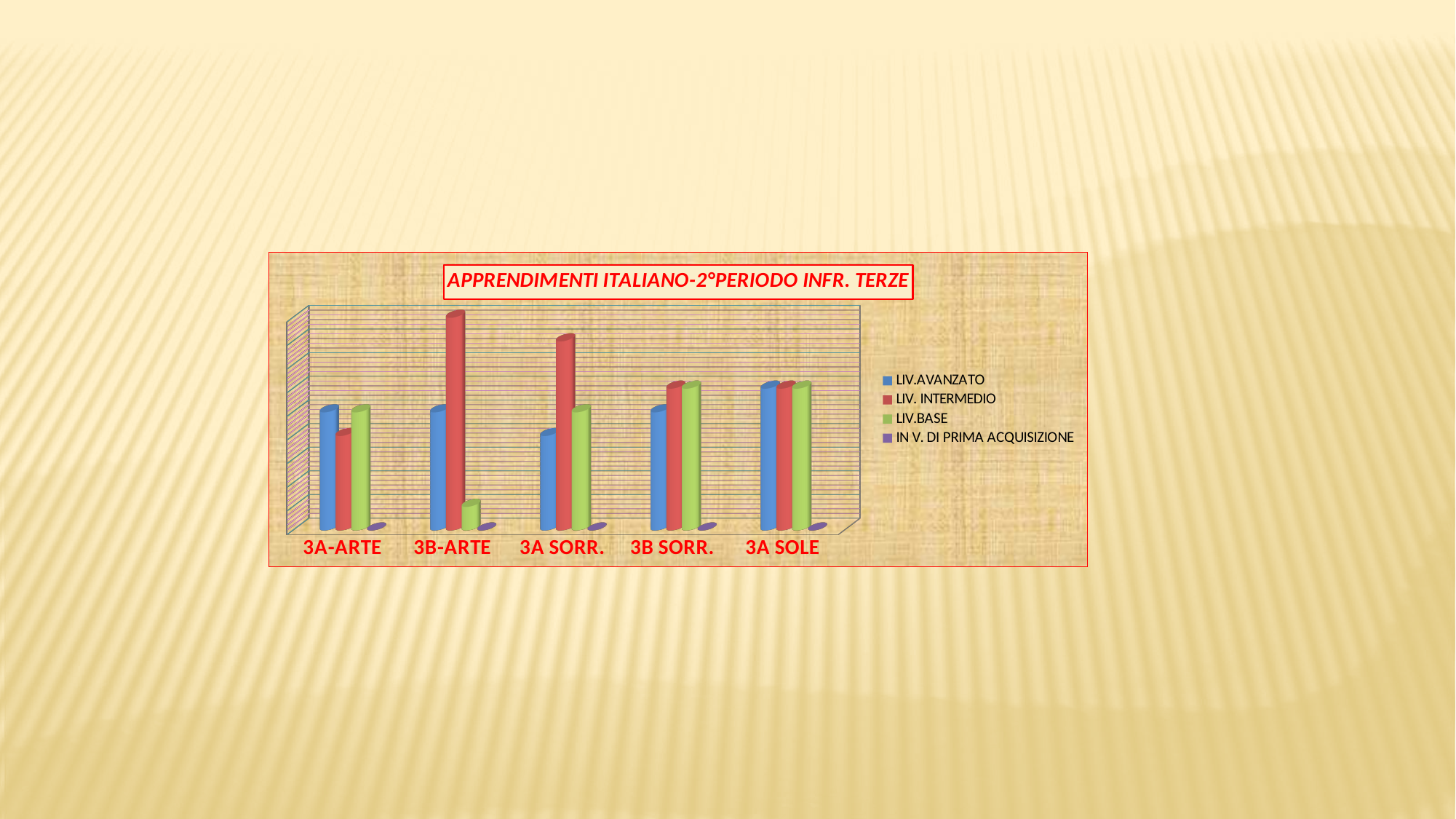
Which series is shown in red in the chart's legend? LIV. INTERMEDIO What is the title of the chart? APPRENDIMENTI ITALIANO-2°PERIODO INFR. TERZE What kind of chart is shown on the slide? bar chart Which class has the lowest LIV. INTERMEDIO bar? 3A-ARTE Which class has the highest LIV. INTERMEDIO bar? 3B-ARTE For 3A SORR., which is larger: LIV. INTERMEDIO or LIV.AVANZATO? LIV. INTERMEDIO How many series does the chart's legend list? 4 Which class has the lowest LIV.AVANZATO bar? 3A SORR. For 3A-ARTE, which is larger: LIV.AVANZATO or LIV. INTERMEDIO? LIV.AVANZATO Which class has the lowest LIV.BASE bar? 3B-ARTE For 3B-ARTE, which is larger: LIV. INTERMEDIO or LIV.BASE? LIV. INTERMEDIO How many classes (categories) are shown on the x axis of the chart? 5